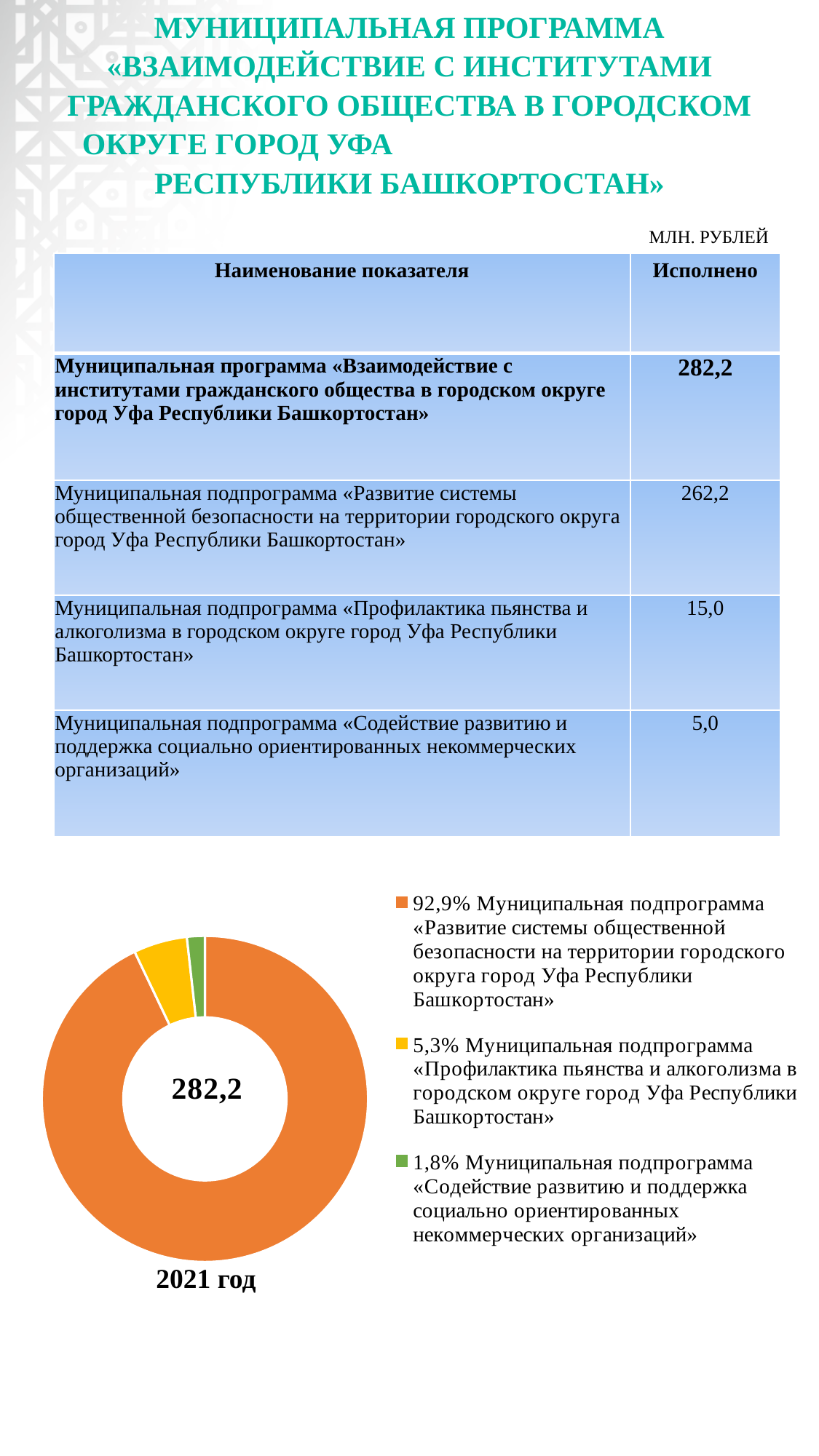
What colour is the largest slice of the doughnut chart? orange What value is printed in the centre of the doughnut chart? 282,2 What share of the doughnut chart does the subprogramme «Содействие развитию и поддержка социально ориентированных некоммерческих организаций» have? 1,8% In the doughnut chart, which slice is larger: «Профилактика пьянства и алкоголизма...» or «Содействие развитию и поддержка социально ориентированных некоммерческих организаций»? «Профилактика пьянства и алкоголизма...» What share of the doughnut chart does the subprogramme «Профилактика пьянства и алкоголизма в городском округе город Уфа Республики Башкортостан» have? 5,3% What share of the doughnut chart does the subprogramme «Развитие системы общественной безопасности на территории городского округа город Уфа Республики Башкортостан» have? 92,9% How many slices does the doughnut chart have? 3 How many entries does the legend of the doughnut chart list? 3 Which subprogramme has the smallest slice in the doughnut chart? «Содействие развитию и поддержка социально ориентированных некоммерческих организаций» What kind of chart is shown at the bottom of the slide? doughnut chart Which subprogramme has the largest slice in the doughnut chart? «Развитие системы общественной безопасности на территории городского округа город Уфа Республики Башкортостан» In the doughnut chart, what is the difference in percentage points between the share of «Профилактика пьянства и алкоголизма...» and the share of «Содействие развитию и поддержка социально ориентированных некоммерческих организаций»? 3,5%